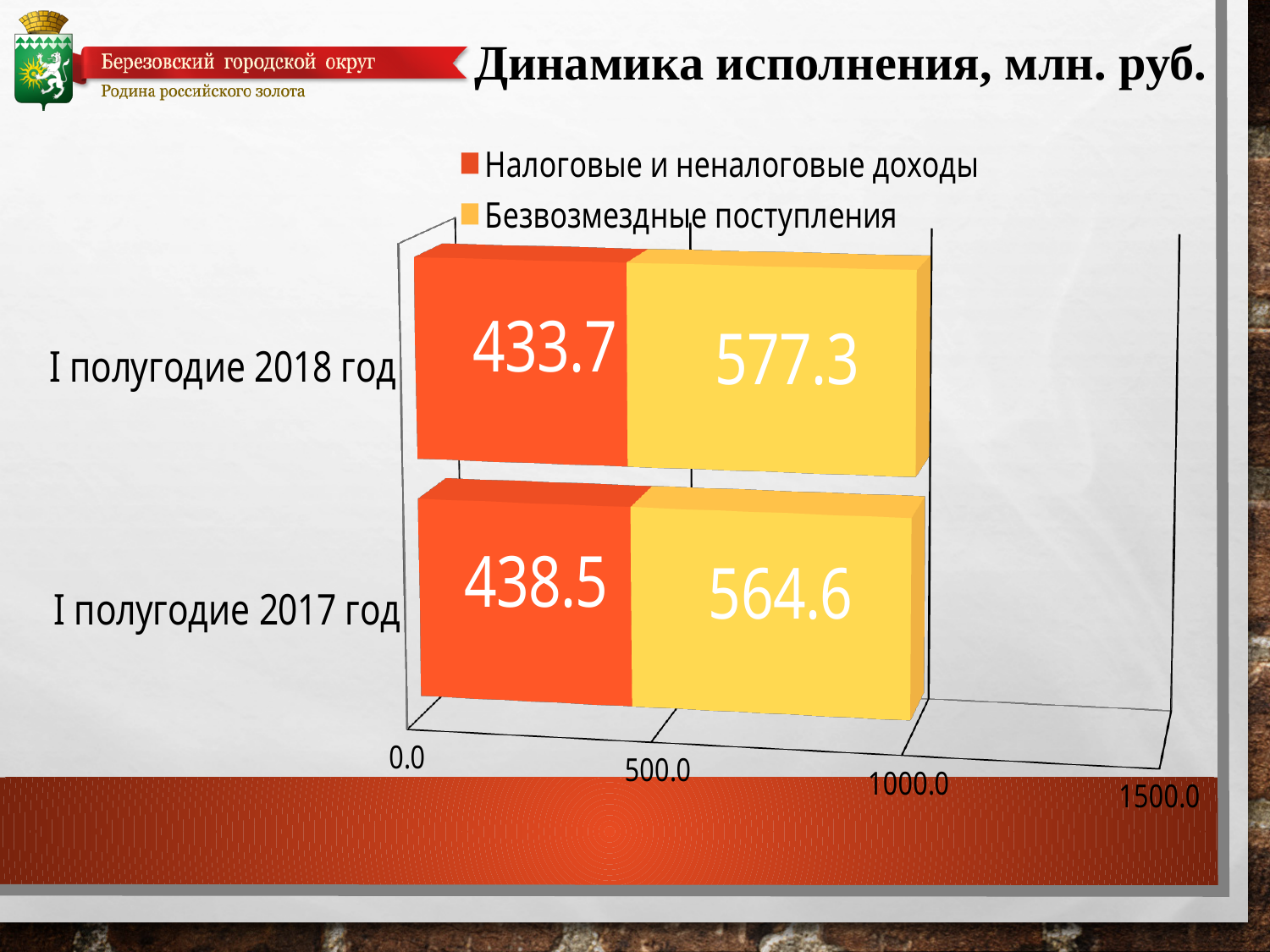
Which is larger for I полугодие 2018 год: Налоговые и неналоговые доходы or Безвозмездные поступления? Безвозмездные поступления What is the total of the stacked bar for I полугодие 2017 год? 1003.1 What is the value of Налоговые и неналоговые доходы for I полугодие 2017 год? 438.5 What is the total of the stacked bar for I полугодие 2018 год? 1011.0 What is the difference between Безвозмездные поступления in I полугодие 2018 год and I полугодие 2017 год? 12.7 What is the value of Налоговые и неналоговые доходы for I полугодие 2018 год? 433.7 How many categories are shown on the chart? 2 What kind of chart is shown on the slide? Stacked bar chart What is the value of Безвозмездные поступления for I полугодие 2017 год? 564.6 What is the difference between Безвозмездные поступления and Налоговые и неналоговые доходы for I полугодие 2017 год? 126.1 What is the value of Безвозмездные поступления for I полугодие 2018 год? 577.3 How many series does the legend list? 2